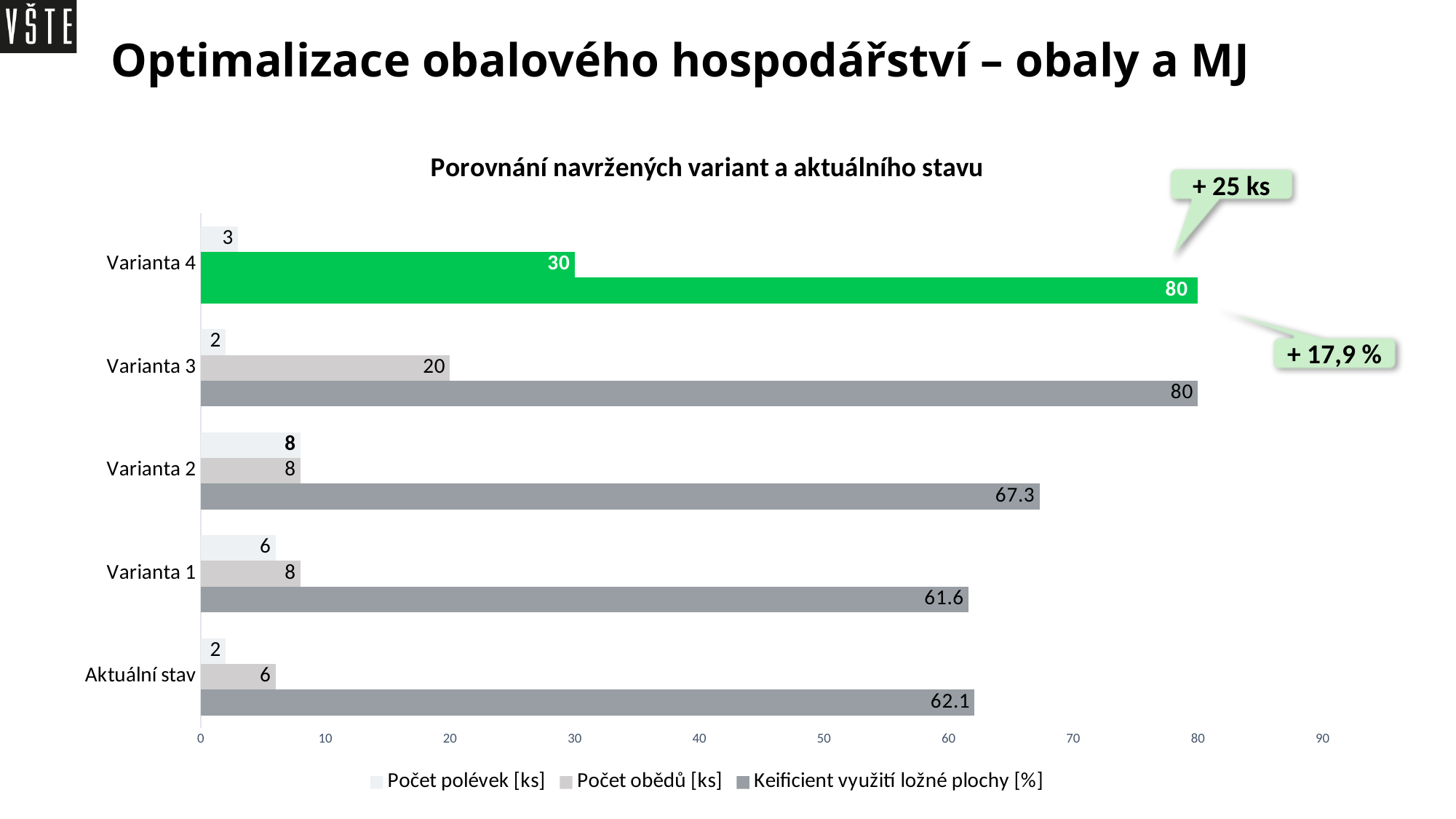
Which category has the lowest value of Keificient využití ložné plochy [%]? Varianta 1 What is the value of Keificient využití ložné plochy [%] for Varianta 2? 67.3 What is the value of Keificient využití ložné plochy [%] for Aktuální stav? 62.1 What is the value of Počet obědů [ks] for Varianta 4? 30 What is the difference between Počet obědů [ks] for Varianta 4 and Varianta 3? 10 Which category has the highest value of Počet obědů [ks]? Varianta 4 What is the value of Počet polévek [ks] for Varianta 1? 6 How many series does the legend list? 3 How many categories are shown on the vertical axis? 5 What is the title of the chart? Porovnání navržených variant a aktuálního stavu Which is larger: Keificient využití ložné plochy [%] for Varianta 2 or for Varianta 1? Varianta 2 What type of chart is shown on the slide? bar chart